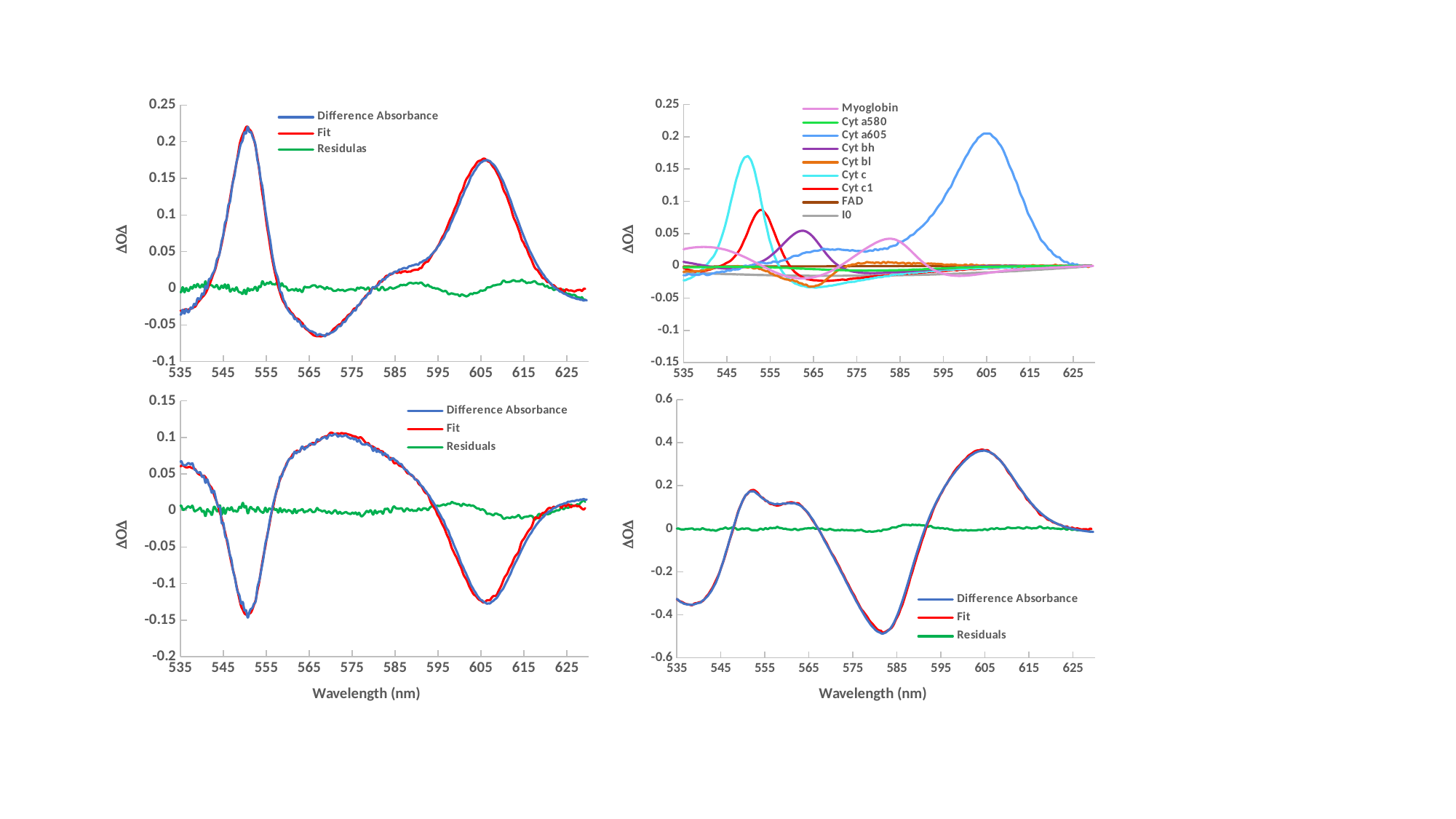
How many series does the legend of the top-right chart list? 9 What colour is the Residuals series in the bottom-right chart? green In the top-right chart, which series reaches the highest value? Cyt a605 What kind of chart is the top-left chart? line chart In the bottom-left chart, is the minimum of the Difference Absorbance series near 551 nm greater or less than -0.1? less In the top-right chart, is the peak value of Cyt c1 greater or less than 0.1? less How many series does the legend of the bottom-right chart list? 3 In the top-left chart, which peak of the Difference Absorbance series is higher: the one near 551 nm or the one near 605 nm? the one near 551 nm What is the x-axis label of the bottom-left chart? Wavelength (nm) In the top-left chart, is the peak of the Difference Absorbance series near 551 nm greater or less than 0.2? greater